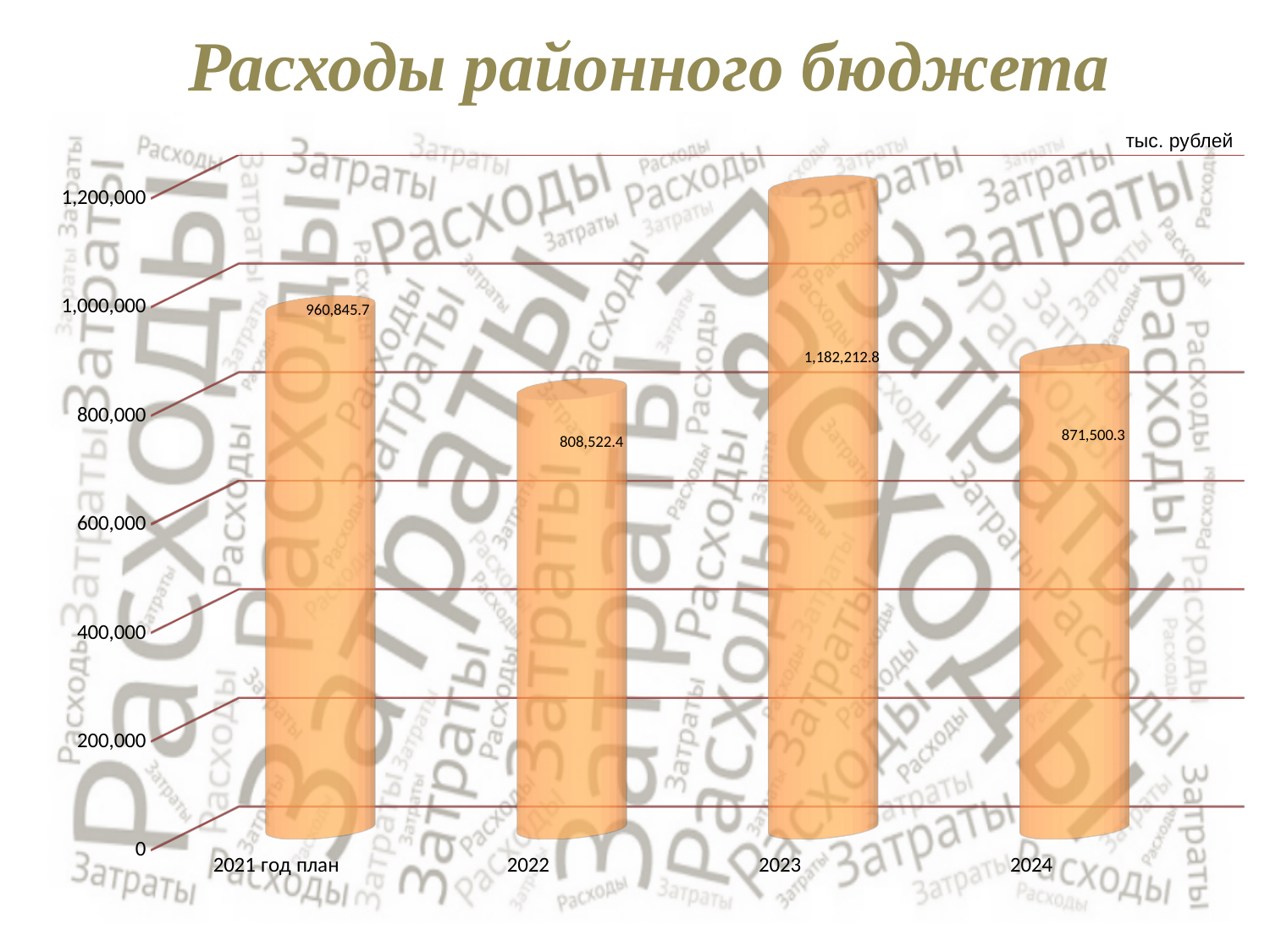
What is the value for 2022? 808,522.4 Which category has the highest value? 2023 What is the title of the chart? Расходы районного бюджета Which category has the lowest value? 2022 What is the difference between the values for 2023 and 2021 год план? 221,367.1 How many categories are shown on the x axis? 4 What is the value for 2023? 1,182,212.8 What is the value for 2024? 871,500.3 Which is larger, the value for 2021 год план or the value for 2024? 2021 год план Is the value for 2023 greater or less than 1,000,000? greater What is the value for 2021 год план? 960,845.7 What is the difference between the values for 2024 and 2022? 62,977.9